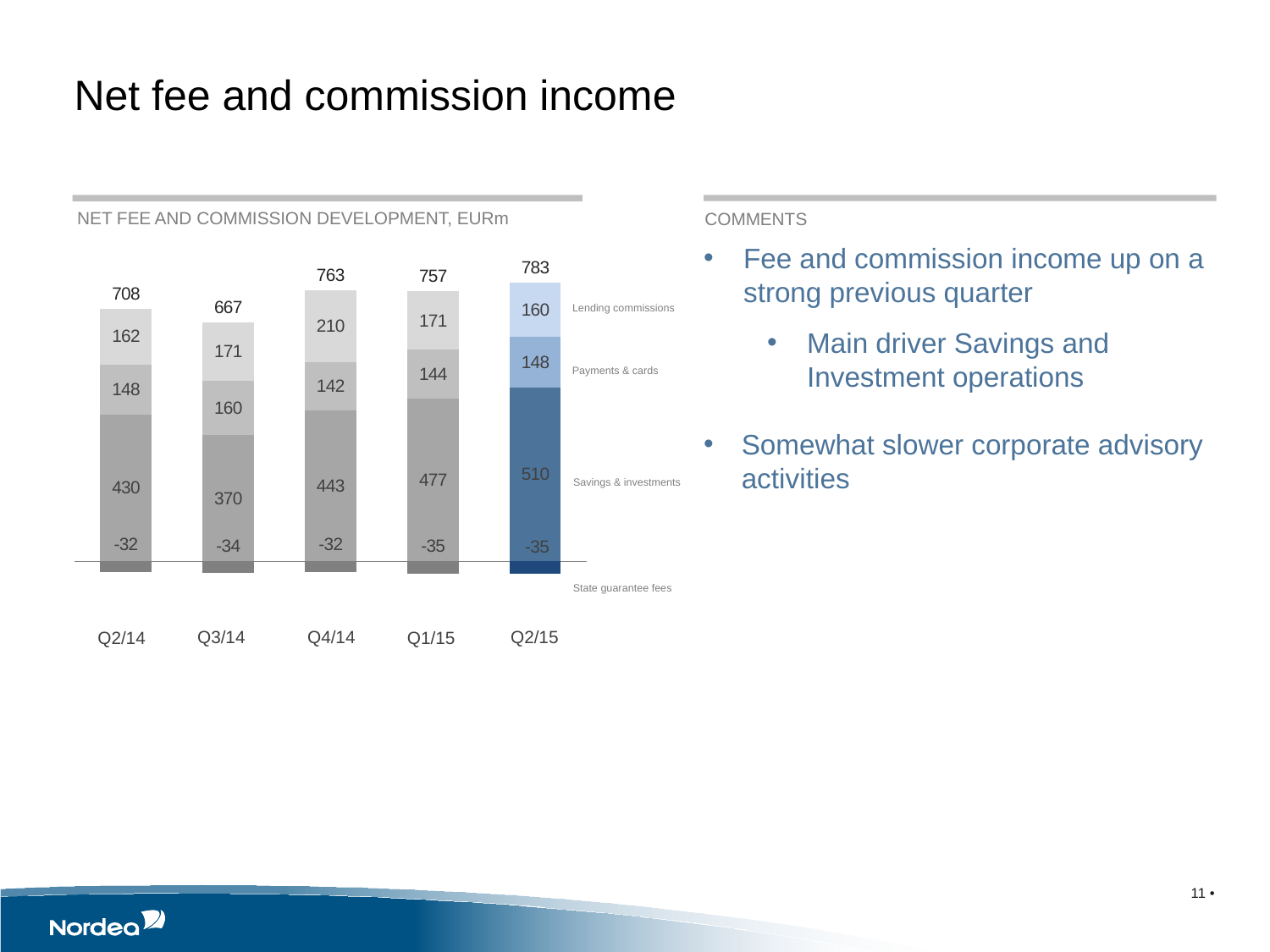
How many series are labelled in the chart? 4 Which quarter has the lowest total net fee and commission income? Q3/14 What is the difference between the total for Q2/15 and the total for Q1/15? 26 What is the State guarantee fees value for Q1/15? -35 What is the Lending commissions value for Q4/14? 210 What is the Payments & cards value for Q3/14? 160 How many quarters are shown on the x axis? 5 What kind of chart is shown? Stacked bar chart Which is larger, Savings & investments in Q4/14 or in Q1/15? Q1/15 What is the Savings & investments value for Q2/15? 510 What is the total shown above the Q2/14 bar? 708 Which quarter has the highest total net fee and commission income? Q2/15